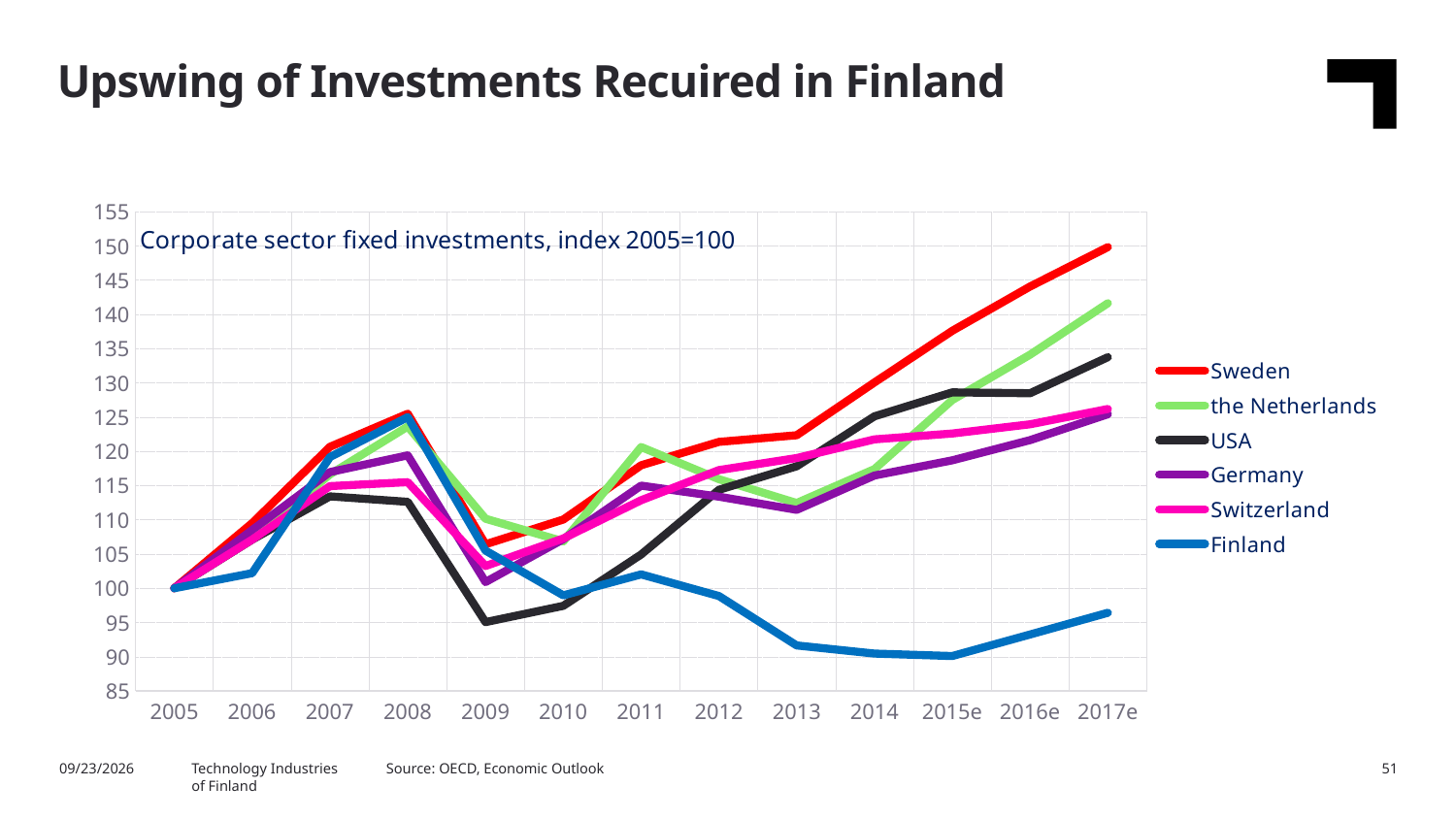
How many series does the legend list? 6 Does the Finland line rise or fall from 2012 to 2015e? fall How many years are shown along the x axis? 13 What kind of chart is shown on the slide? line chart In 2017e, which is higher: the Netherlands or USA? the Netherlands Is the value for Sweden in 2017e greater or less than 145? greater Which country has the lowest index value in 2017e? Finland Is the value for USA in 2009 greater or less than 100? less What is the subtitle shown inside the chart area? Corporate sector fixed investments, index 2005=100 Which country has the highest index value in 2017e? Sweden What is the index value for Finland in 2005? 100 Is the value for Finland in 2015e greater or less than 95? less